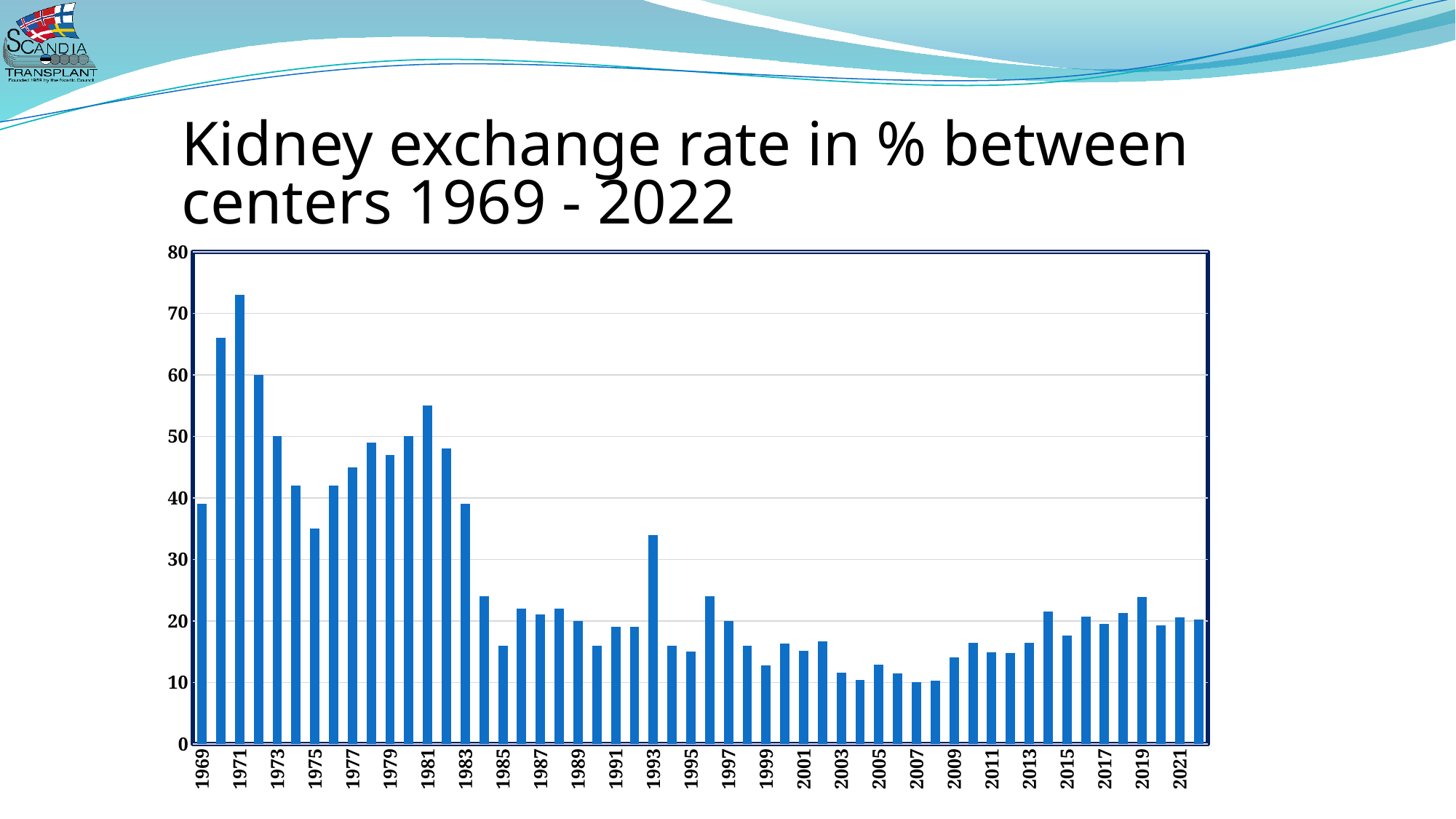
Do the values generally rise or fall from 1971 to 1985? fall Is the value for 1993 greater or less than 30? greater How many years (bars) are plotted in the chart? 54 Is the value for 1981 greater or less than 50? greater Is the value for 1971 greater or less than 70? greater What is the title of the chart? Kidney exchange rate in % between centers 1969 - 2022 Which year has the larger value, 1993 or 1996? 1993 What kind of chart is shown on the slide? bar chart Which year has the highest kidney exchange rate? 1971 Which year has the larger value, 1970 or 1972? 1970